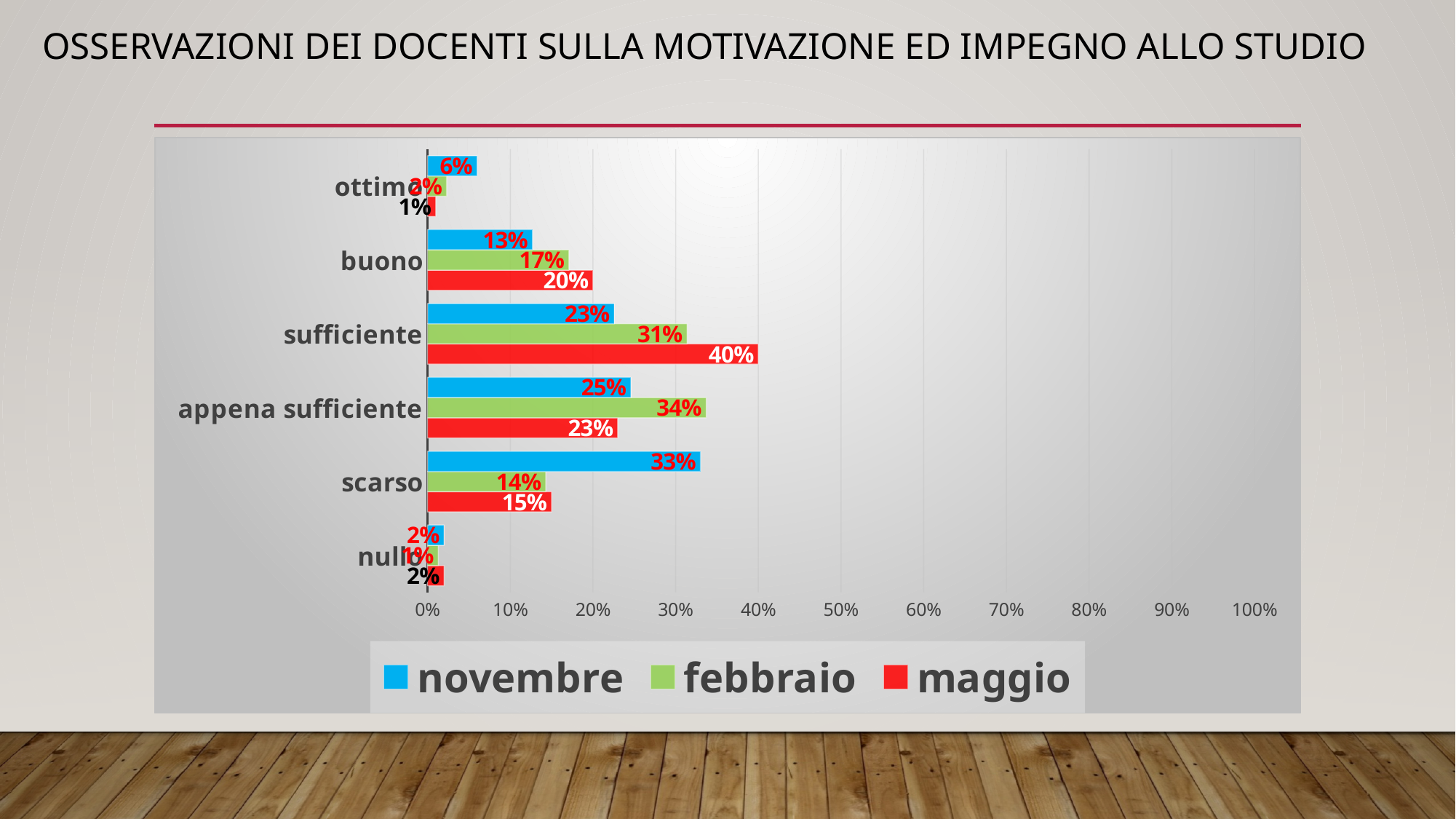
What kind of chart is shown on the slide? bar chart What is the value for maggio in the sufficiente category? 40% What is the value for febbraio in the appena sufficiente category? 34% What is the difference between the maggio and novembre values in the sufficiente category? 17% Which category has the highest value for the novembre series? scarso How many series does the legend list? 3 Which category has the highest value for the maggio series? sufficiente In the buono category, which is larger: febbraio or maggio? maggio What is the value for novembre in the scarso category? 33% What colour represents the maggio series in the legend? red What is the difference between the febbraio and maggio values in the appena sufficiente category? 11% What is the value for maggio in the buono category? 20%